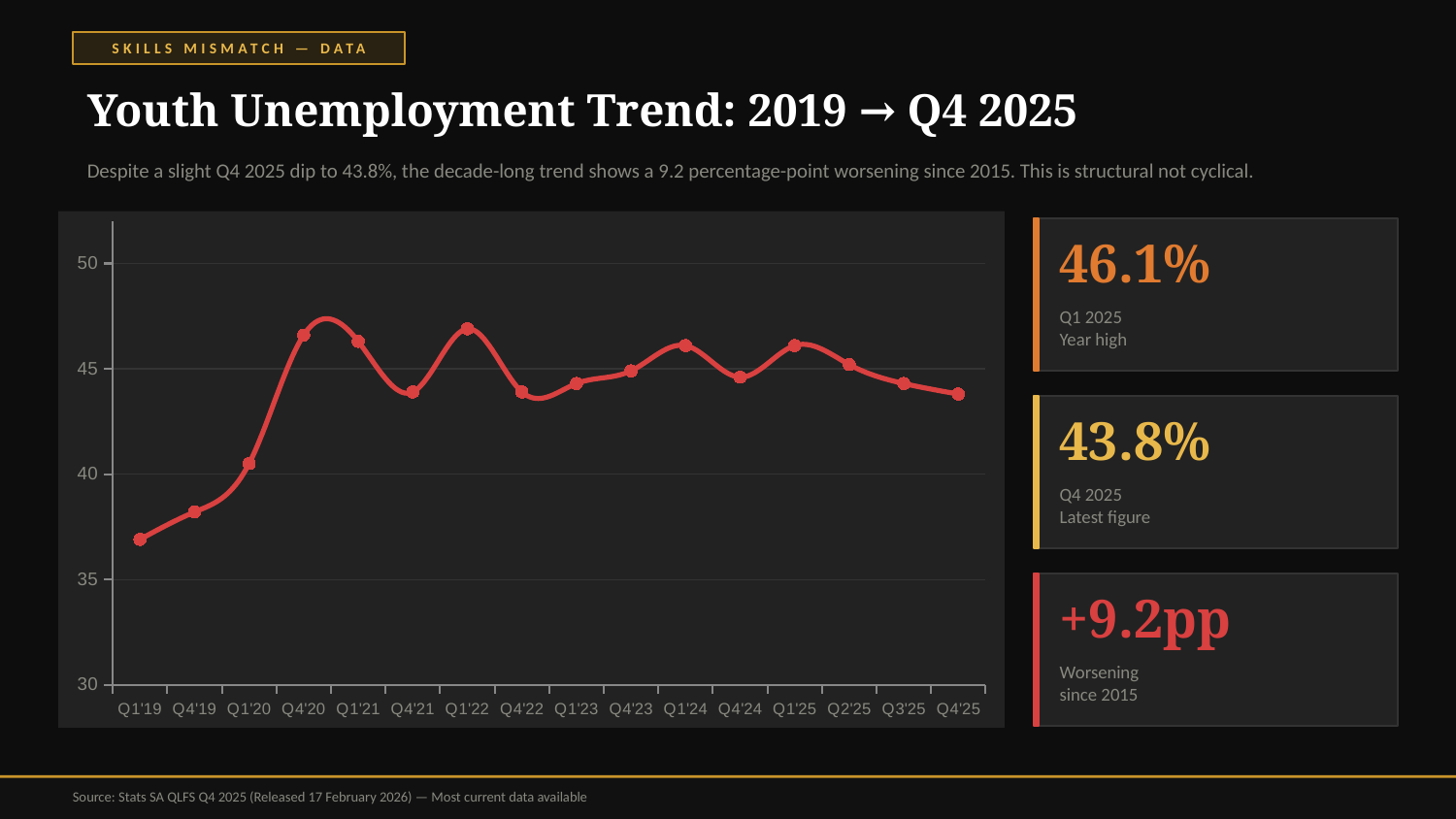
What is the difference between the Q1'25 value and the Q4'25 value? 2.3 percentage points Overall, do the values rise or fall from Q1'19 to Q4'25? rise Is the value for Q4'20 greater or less than 45? greater Is the value for Q4'21 greater or less than 45? less Which quarter has the lowest value on the chart? Q1'19 What is the youth unemployment value for Q1'25? 46.1% Is the value for Q1'19 greater or less than 40? less What kind of chart is shown on the slide? line chart How many data points are plotted on the line chart? 16 What is the title of the slide containing the chart? Youth Unemployment Trend: 2019 → Q4 2025 What is the youth unemployment value for Q4'25? 43.8% Which is larger, the value for Q1'19 or the value for Q4'25? Q4'25